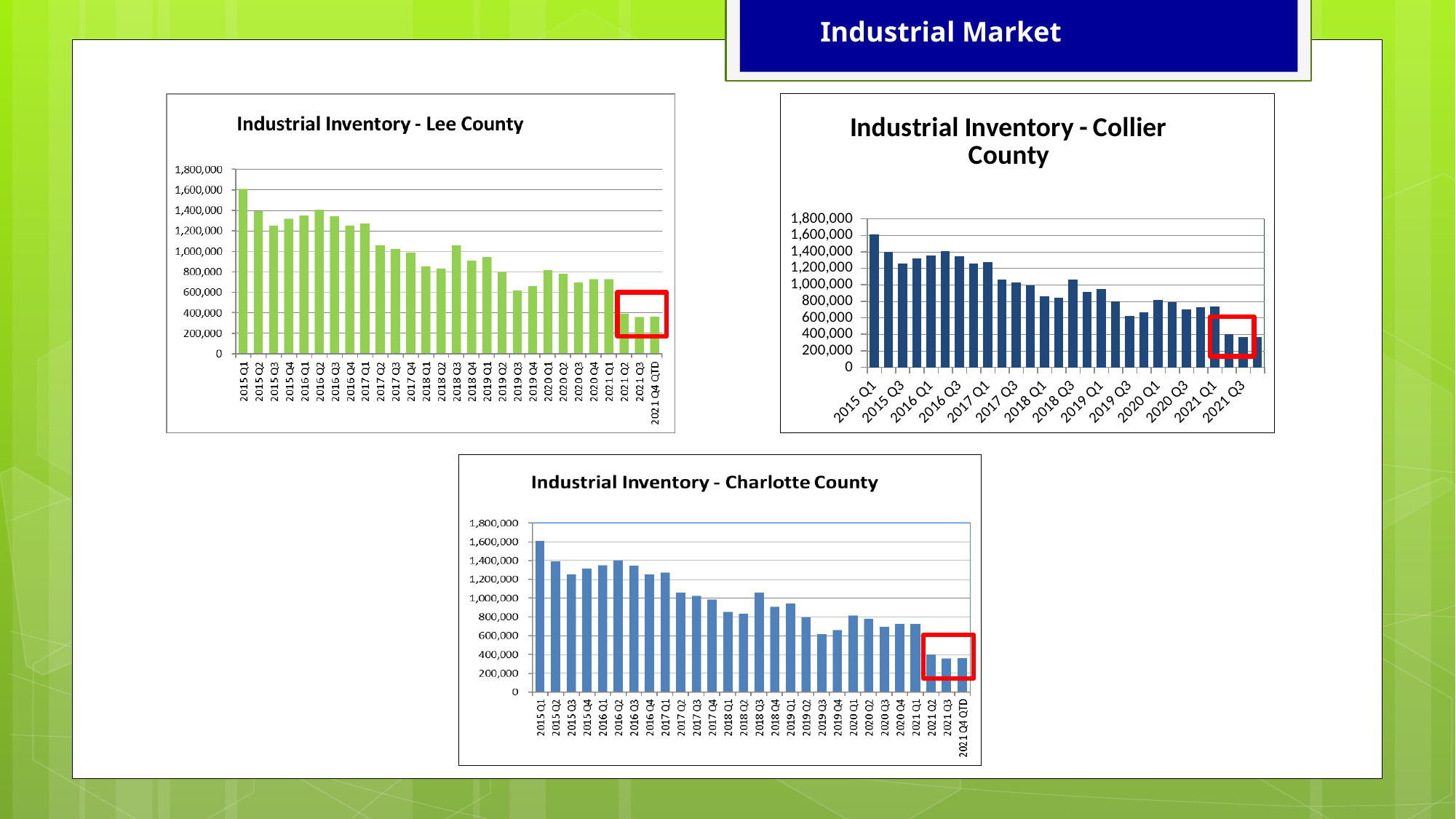
In the "Industrial Inventory - Collier County" chart, do the values generally rise or fall from 2015 Q1 to 2021? Fall In the "Industrial Inventory - Collier County" chart, is the value for 2019 Q3 greater or less than 800,000? less In the "Industrial Inventory - Charlotte County" chart, is the value for 2018 Q3 greater or less than 1,000,000? greater In the "Industrial Inventory - Lee County" chart, is the value for 2021 Q2 greater or less than 600,000? less In the "Industrial Inventory - Lee County" chart, how many quarters are plotted along the x axis? 28 In the "Industrial Inventory - Charlotte County" chart, which is larger, the value for 2019 Q1 or the value for 2019 Q3? 2019 Q1 What colour are the bars in the "Industrial Inventory - Lee County" chart? Green In the "Industrial Inventory - Collier County" chart, which quarter has the highest inventory? 2015 Q1 What kind of chart is the "Industrial Inventory - Lee County" chart? Bar chart In the "Industrial Inventory - Lee County" chart, which quarter has the highest inventory? 2015 Q1 In the "Industrial Inventory - Charlotte County" chart, which is larger, the value for 2015 Q1 or the value for 2015 Q2? 2015 Q1